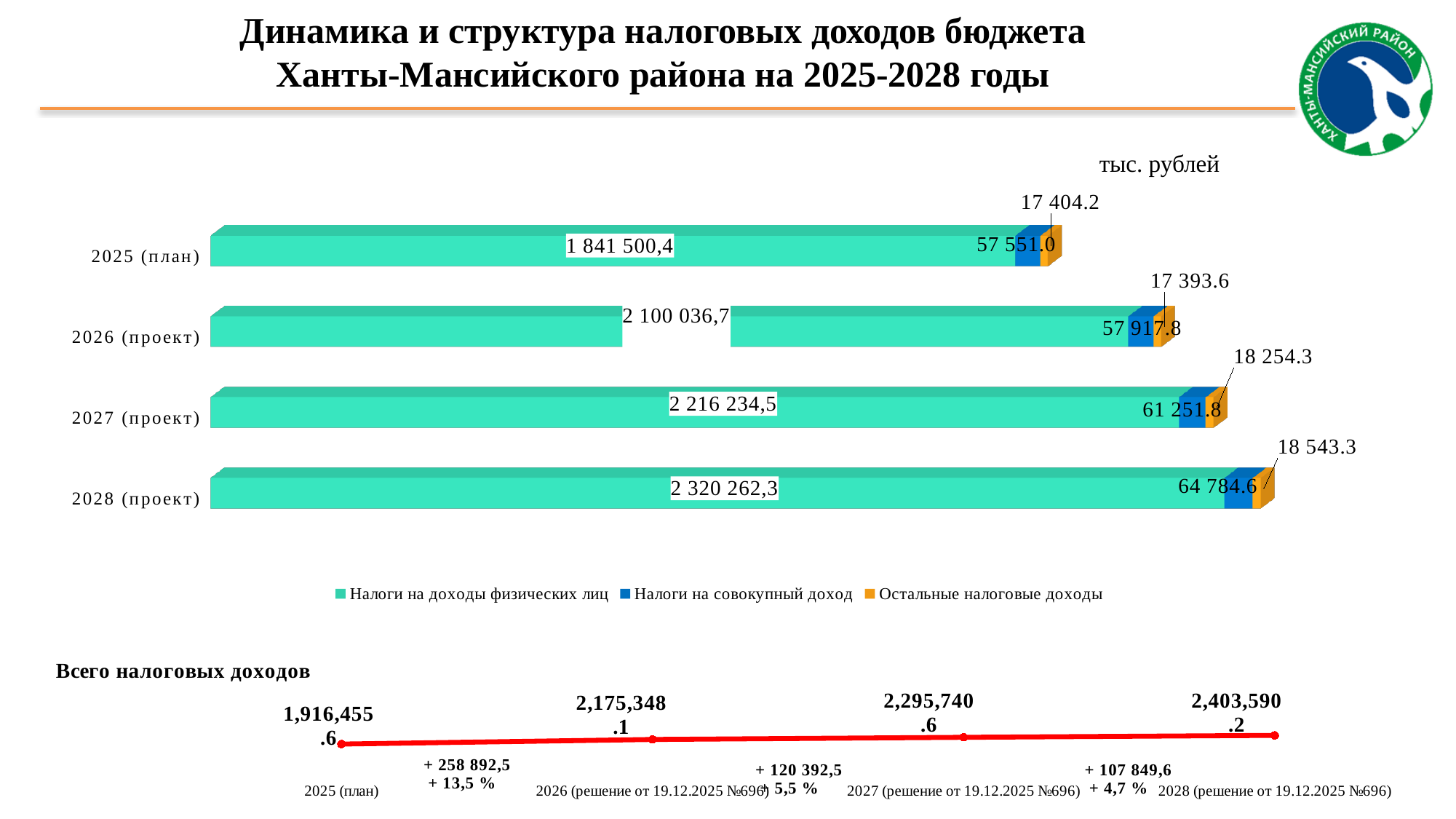
In the bottom line chart 'Всего налоговых доходов', what is the value for 2025 (план)? 1,916,455.6 In the top stacked bar chart, how many series does the legend list? 3 In the top stacked bar chart, what is the value of Налоги на доходы физических лиц for 2025 (план)? 1 841 500,4 In the top stacked bar chart, what is the value of Остальные налоговые доходы for 2027 (проект)? 18 254.3 What kind of chart is the top chart on the slide? Stacked bar chart In the bottom line chart 'Всего налоговых доходов', what is the value for 2028? 2,403,590.2 In the top stacked bar chart, which year has the lowest value for Остальные налоговые доходы? 2026 (проект) In the top stacked bar chart, which year has the highest value for Налоги на доходы физических лиц? 2028 (проект) In the bottom line chart 'Всего налоговых доходов', do the values rise or fall from 2025 to 2028? Rise In the top stacked bar chart, which is larger: Налоги на совокупный доход for 2027 (проект) or for 2026 (проект)? 2027 (проект) In the top stacked bar chart, what is the value of Налоги на совокупный доход for 2028 (проект)? 64 784.6 In the top stacked bar chart, how many years (categories) are shown? 4